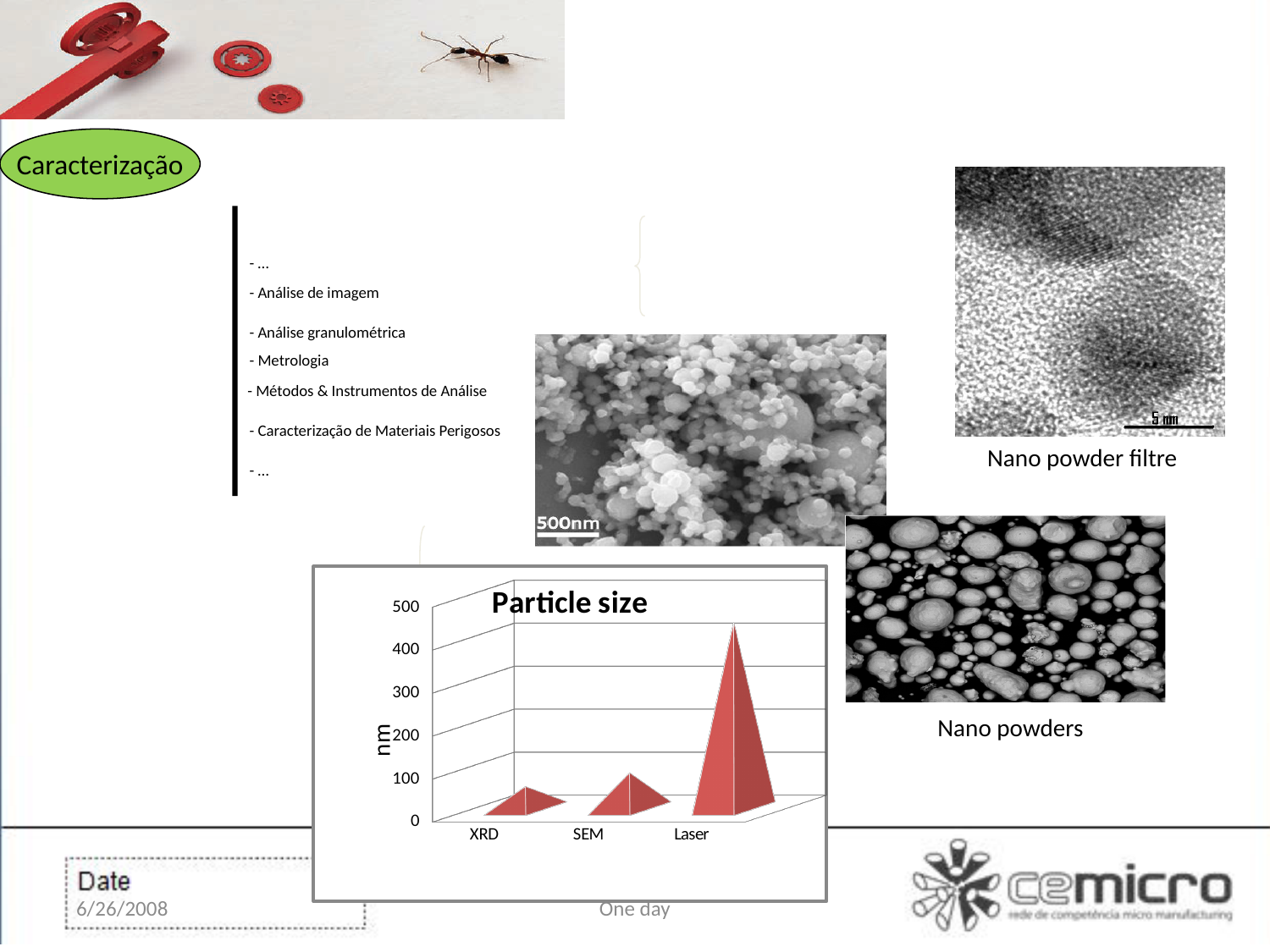
In the Particle size chart, which is larger, the value for SEM or the value for XRD? SEM Which category has the highest value in the Particle size chart? Laser Do the values in the Particle size chart rise or fall from XRD to Laser along the x axis? rise In the Particle size chart, is the value for XRD greater or less than 100? less In the Particle size chart, is the value for Laser greater or less than 300? greater What kind of chart is the Particle size chart? bar chart Which category has the lowest value in the Particle size chart? XRD What unit is shown on the vertical axis of the Particle size chart? nm In the Particle size chart, which is larger, the value for Laser or the value for SEM? Laser How many categories are shown on the x axis of the Particle size chart? 3 In the Particle size chart, is the value for SEM greater or less than 200? less What is the title of the chart on the slide? Particle size